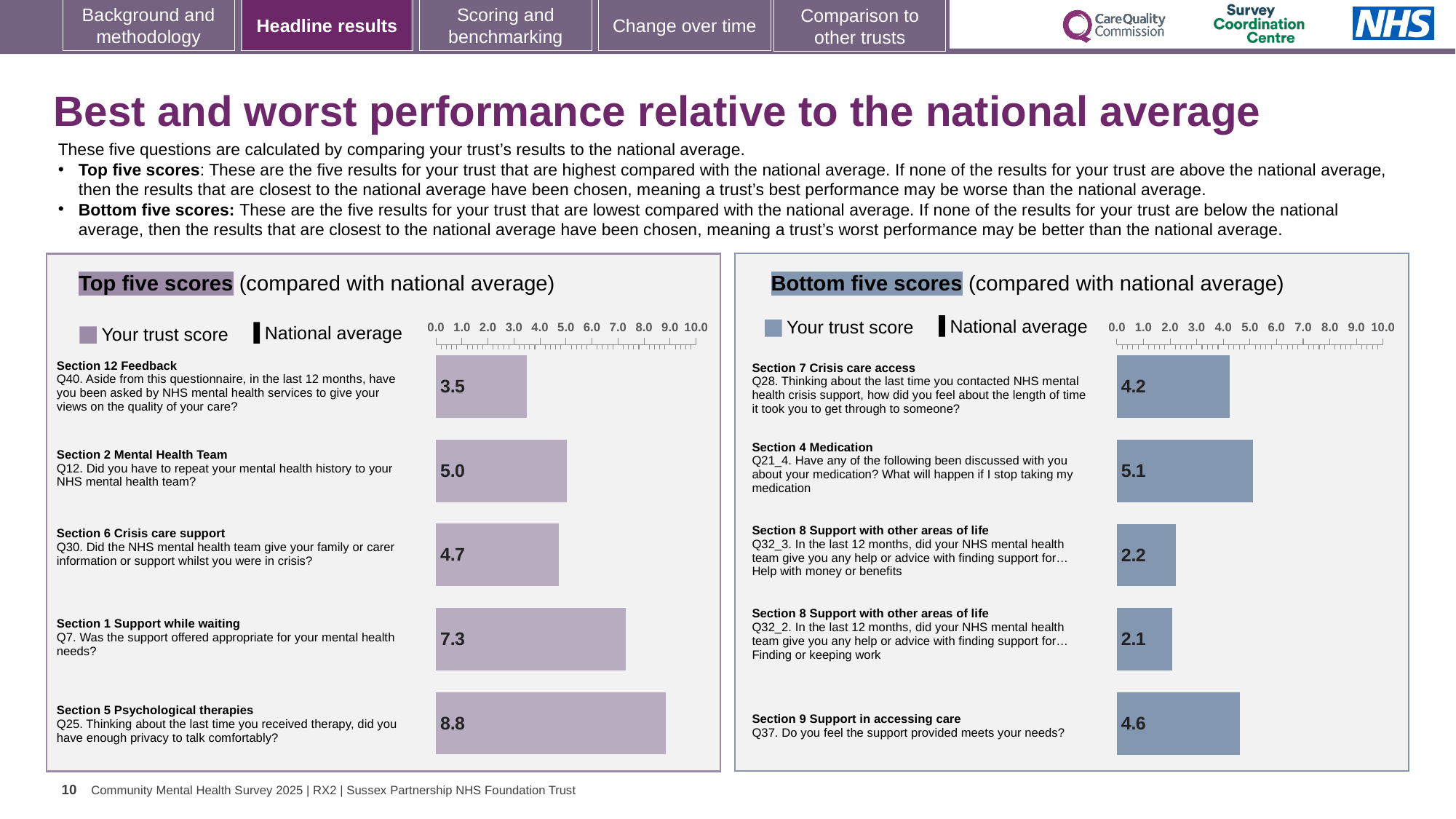
What kind of chart is the Top five scores chart? Bar chart In the Top five scores chart, which question has the highest trust score? Q25 (Section 5 Psychological therapies) How many bars are shown in the Bottom five scores chart? 5 In the Bottom five scores chart, what is the difference between the trust scores for Q21_4 and Q32_2? 3.0 In the Top five scores chart, which question has the lowest trust score? Q40 (Section 12 Feedback) In the Bottom five scores chart, what is the trust score for Q37 (Section 9 Support in accessing care)? 4.6 In the Top five scores chart, what is the trust score for Q25 (Section 5 Psychological therapies)? 8.8 In the Bottom five scores chart, which question has the highest trust score? Q21_4 (Section 4 Medication) In the Bottom five scores chart, which has the larger trust score: Q28 or Q37? Q37 In the Top five scores chart, what is the trust score for Q12 (Section 2 Mental Health Team)? 5.0 In the Top five scores chart, what is the difference between the trust scores for Q25 and Q7? 1.5 In the Bottom five scores chart, what is the trust score for Q28 (Section 7 Crisis care access)? 4.2